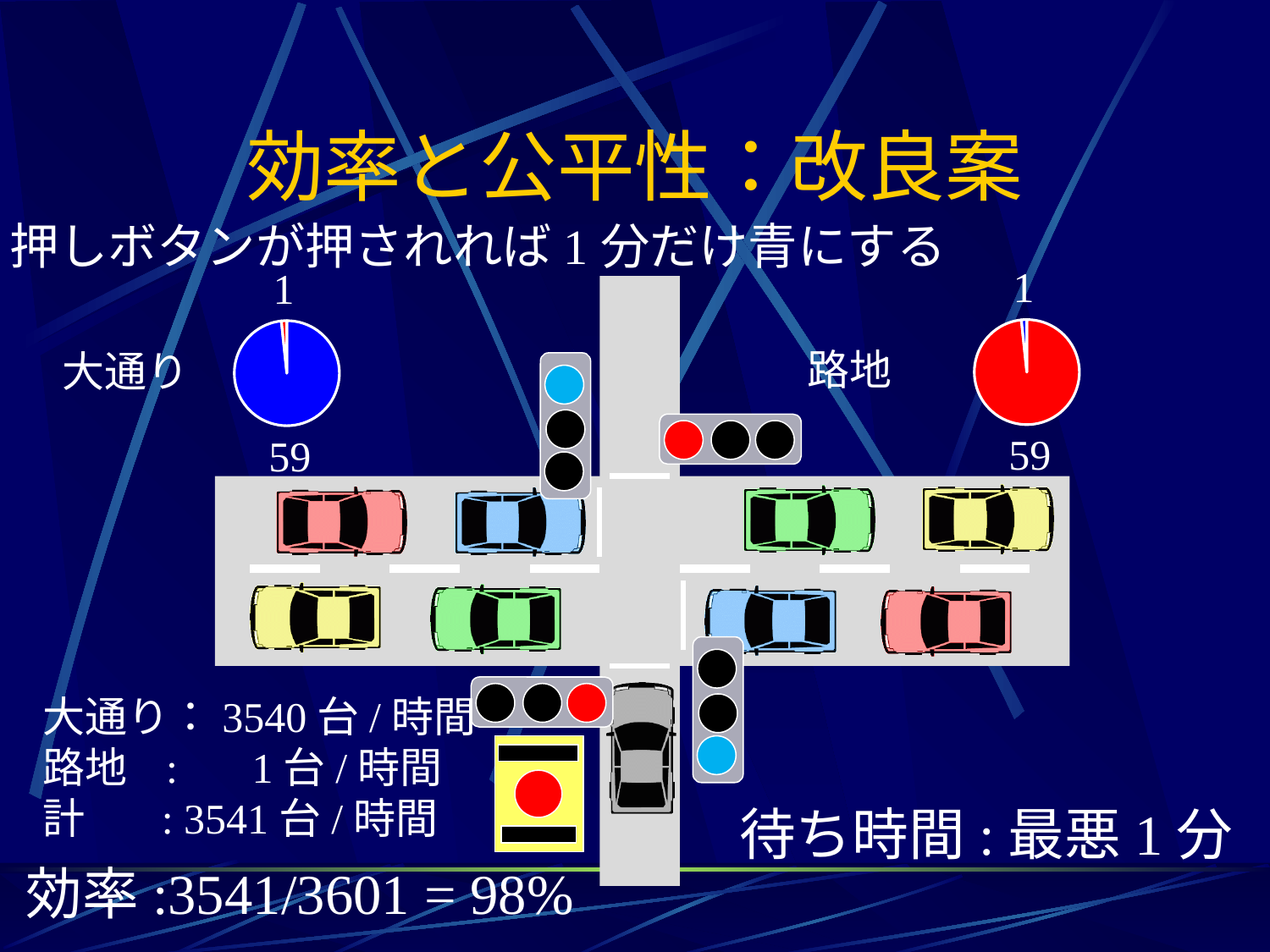
In the 大通り pie chart, what is the total of the two slice values? 60 In the 大通り pie chart, what value is labelled on the small slice? 1 In the 大通り pie chart, what value is labelled on the large slice? 59 How many pie charts are on the slide? 2 What kind of chart is shown next to the label 大通り? pie chart In the 路地 pie chart, what is the smallest slice value? 1 In the 路地 pie chart, what value is labelled on the large slice? 59 In the 大通り pie chart, what is the largest slice value? 59 What colour is the large slice of the 路地 pie chart? red In the 大通り pie chart, how many slices are there? 2 In the 路地 pie chart, which slice is larger, the one labelled 1 or the one labelled 59? 59 In the 路地 pie chart, what is the difference between the two slice values? 58